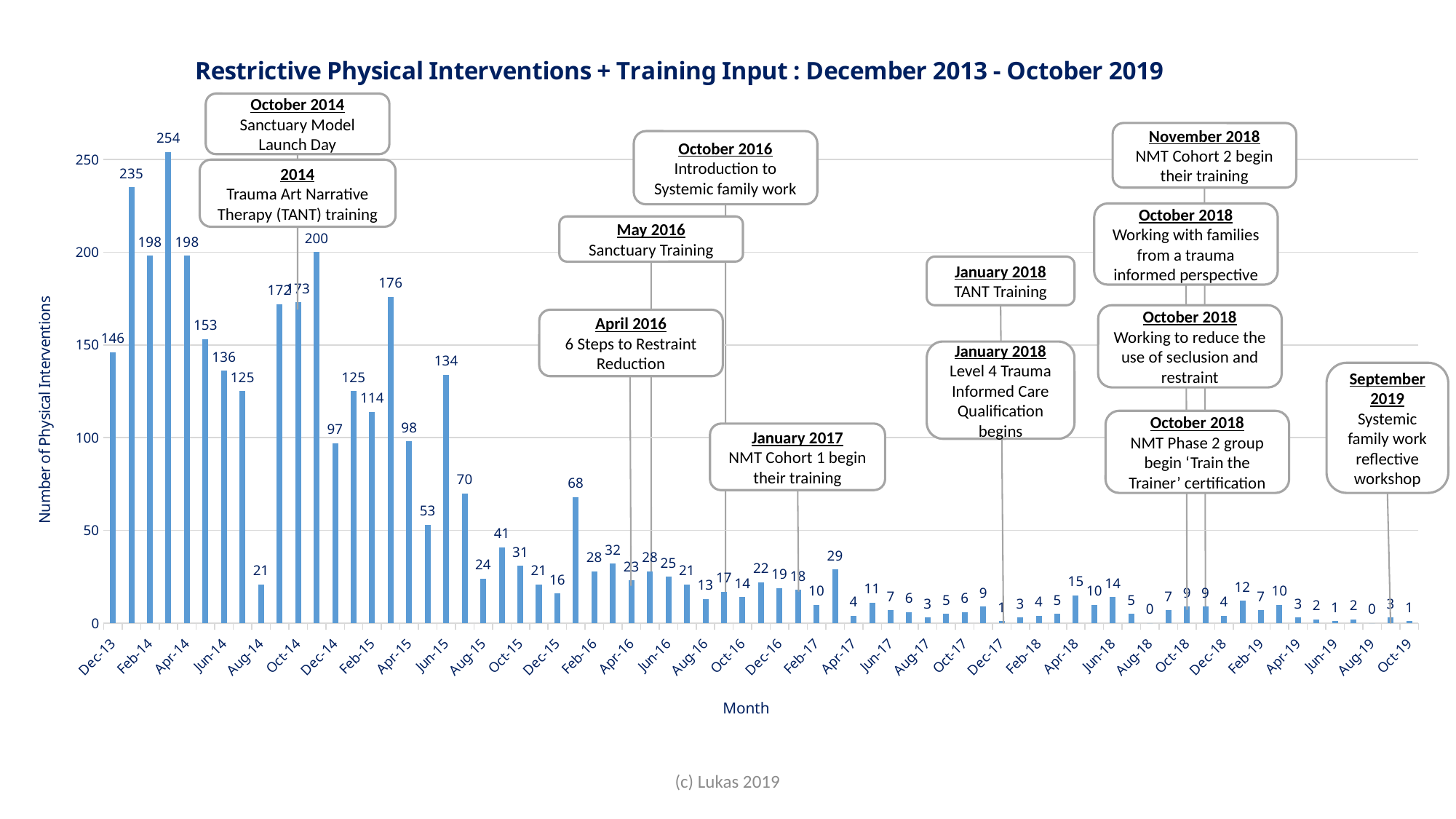
Which is larger, the value for Aug-14 or the value for Oct-14? Oct-14 According to the annotation, what event took place in October 2014? Sanctuary Model Launch Day What is the number of physical interventions for Jun-15? 134 What is the lowest value shown on the chart? 0 What is the number of physical interventions for Apr-18? 15 What is the number of physical interventions for Dec-13? 146 What kind of chart is shown on the slide? bar chart What is the highest value shown on the chart? 254 What is the difference between the values for Dec-14 and Dec-15? 81 What is the difference between the values for Feb-14 and Dec-13? 52 Do the values generally rise or fall from December 2013 to October 2019? fall What is the number of physical interventions for Oct-19? 1